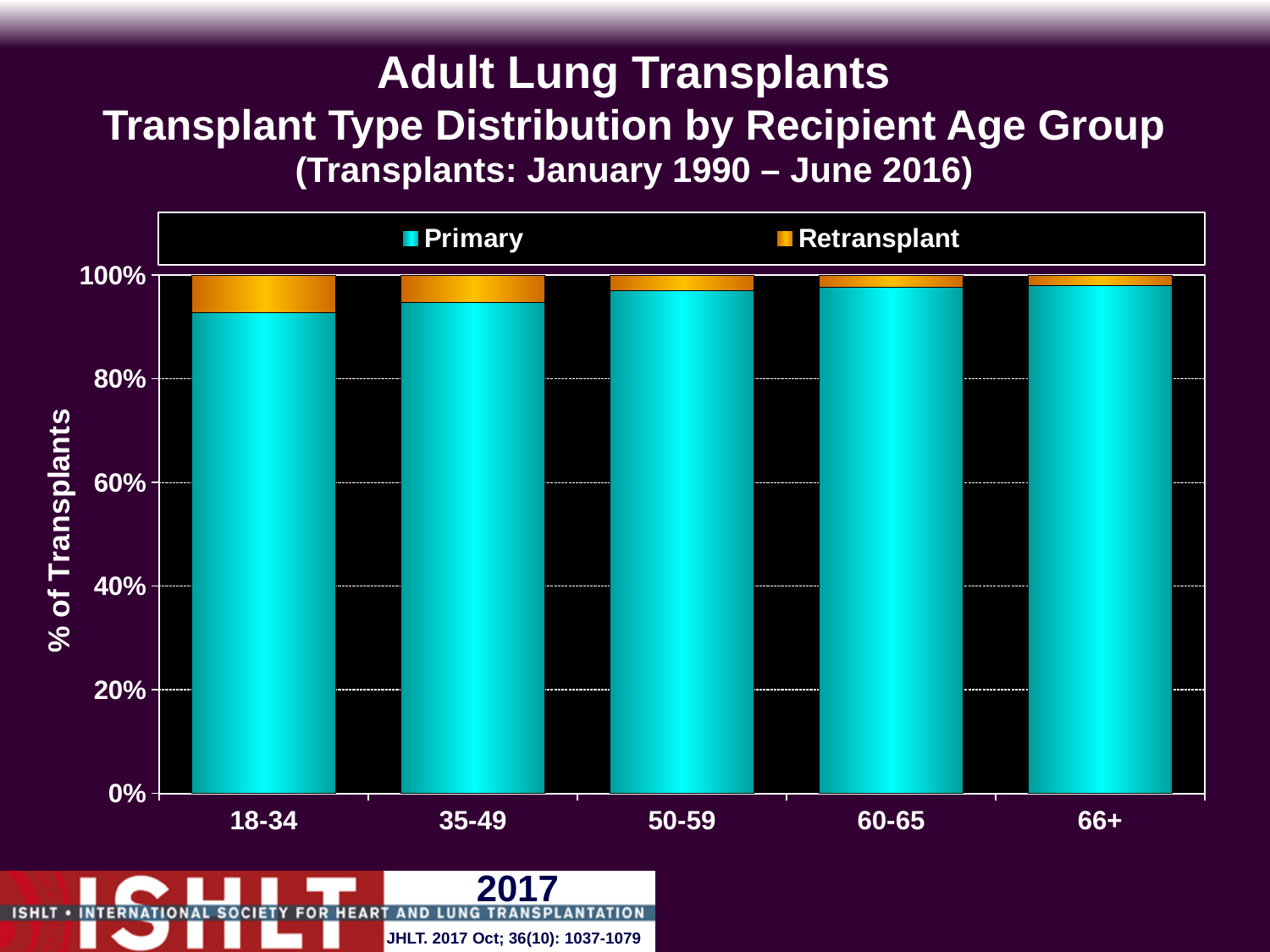
What kind of chart is shown on the slide? Stacked bar chart Which age group has the largest Retransplant share? 18-34 How many series does the legend list? 2 How many recipient age groups are shown on the x axis? 5 Which is larger, the Retransplant share for 18-34 or for 66+? 18-34 Which age group has the smallest Primary share? 18-34 Which series is shown in orange in the legend? Retransplant What is the total height of each stacked bar? 100% Is the Retransplant value for the 66+ age group greater or less than 20%? less Does the Primary share rise or fall as recipient age group increases? Rises Is the Primary value for the 18-34 age group greater or less than 80%? greater Is the Primary value for the 18-34 age group greater or less than 100%? less